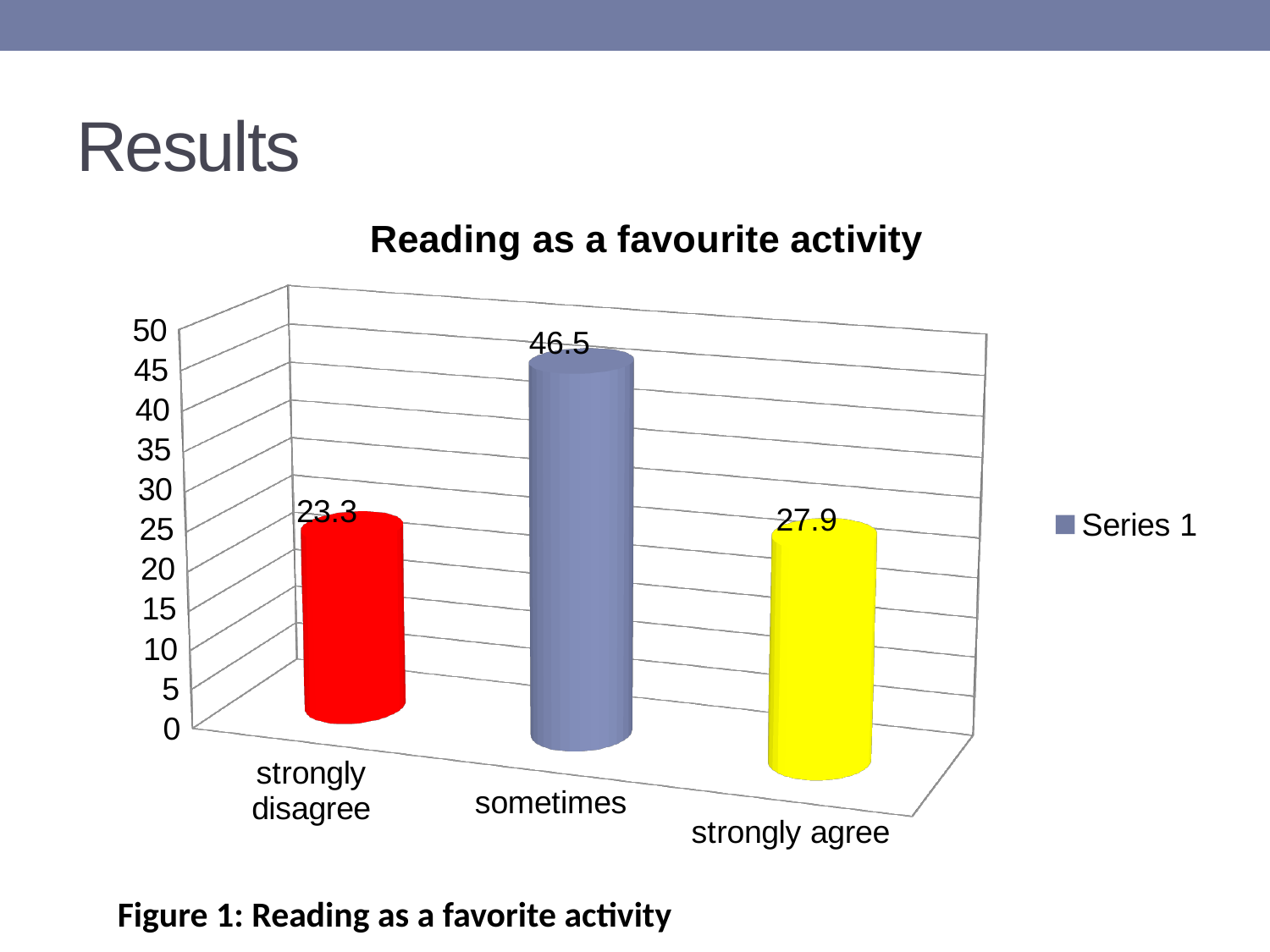
What is the difference between the values for "sometimes" and "strongly agree"? 18.6 Which is larger, the value for "strongly agree" or the value for "strongly disagree"? strongly agree What is the value for "sometimes"? 46.5 How many categories are shown on the x axis? 3 What kind of chart is shown on the slide? bar chart Which category has the lowest value? strongly disagree What is the title of the chart? Reading as a favourite activity Which category has the highest value? sometimes What is the value for "strongly disagree"? 23.3 Is the value for "sometimes" greater or less than 40? greater What is the difference between the values for "strongly agree" and "strongly disagree"? 4.6 What is the value for "strongly agree"? 27.9